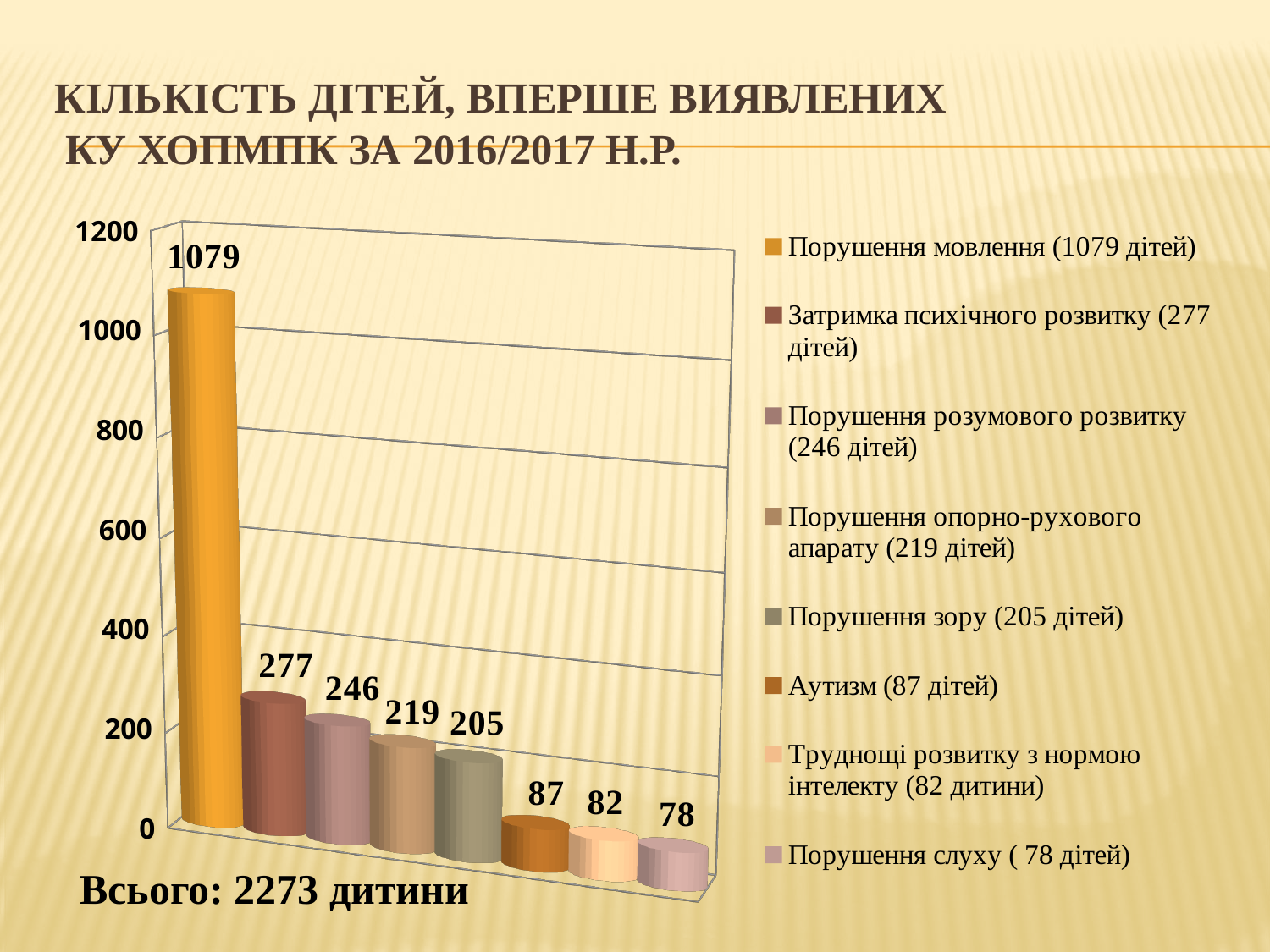
Which category has the highest value? Порушення мовлення What is the difference between the values for Порушення розумового розвитку and Порушення опорно-рухового апарату? 27 What kind of chart is shown on the slide? Bar chart What is the value for Порушення мовлення? 1079 What total number of children is stated below the chart? 2273 дитини What is the difference between the values for Порушення мовлення and Затримка психічного розвитку? 802 What is the value for Порушення зору? 205 What is the value for Аутизм? 87 What is the value for Затримка психічного розвитку? 277 Which is larger, the value for Аутизм or the value for Порушення слуху? Аутизм How many bars are shown in the chart? 8 Which category has the lowest value? Порушення слуху